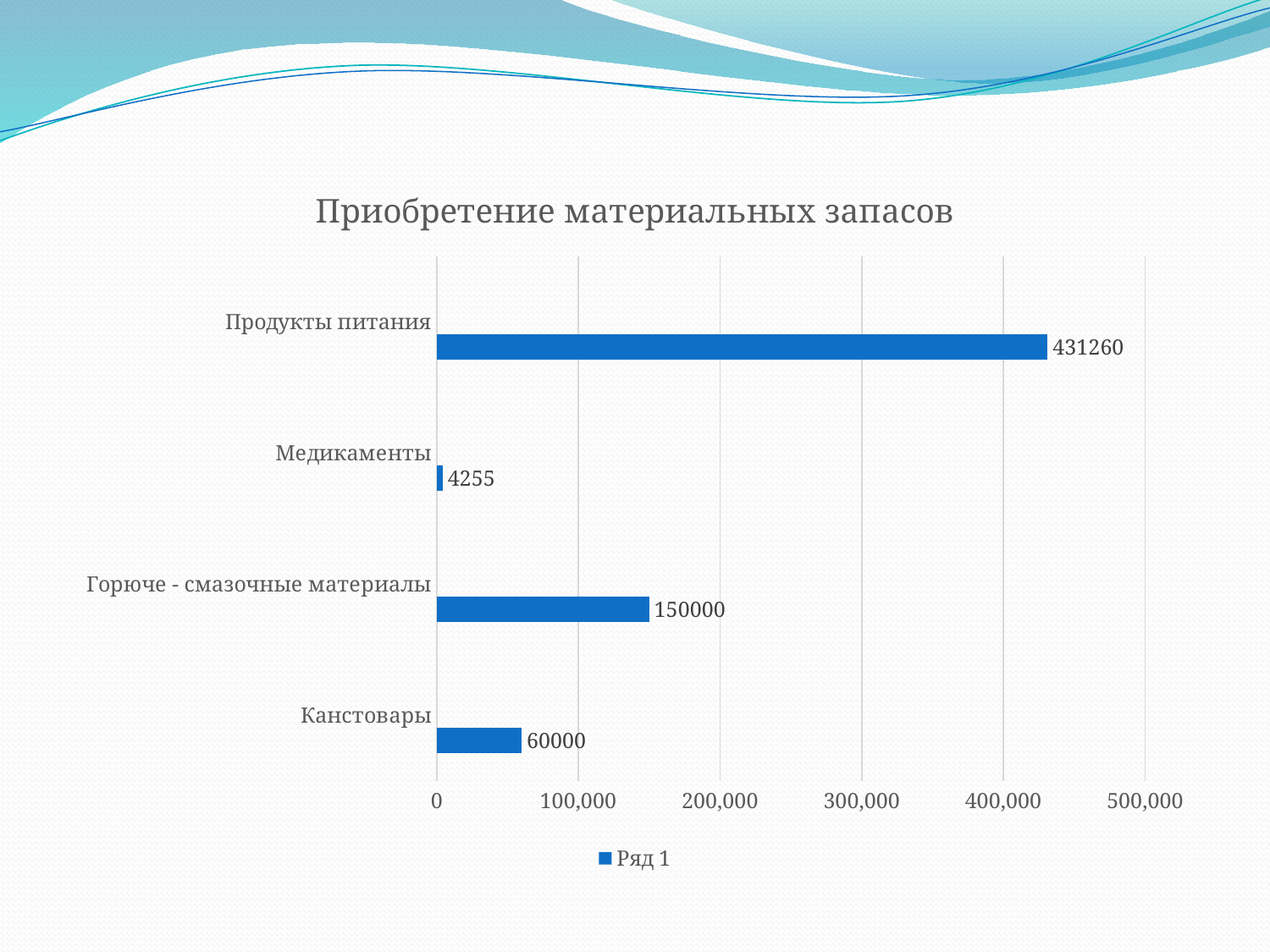
Is the value for Продукты питания greater or less than 400,000? greater What is the value for Медикаменты? 4255 What kind of chart is shown on the slide? bar chart Which category has the highest value? Продукты питания What is the title of the chart? Приобретение материальных запасов What is the value for Горюче - смазочные материалы? 150000 What is the value for Продукты питания? 431260 What is the value for Канстовары? 60000 How many categories are shown in the chart? 4 What is the difference between the values for Горюче - смазочные материалы and Канстовары? 90000 Which category has the lowest value? Медикаменты Which is larger, the value for Канстовары or the value for Медикаменты? Канстовары